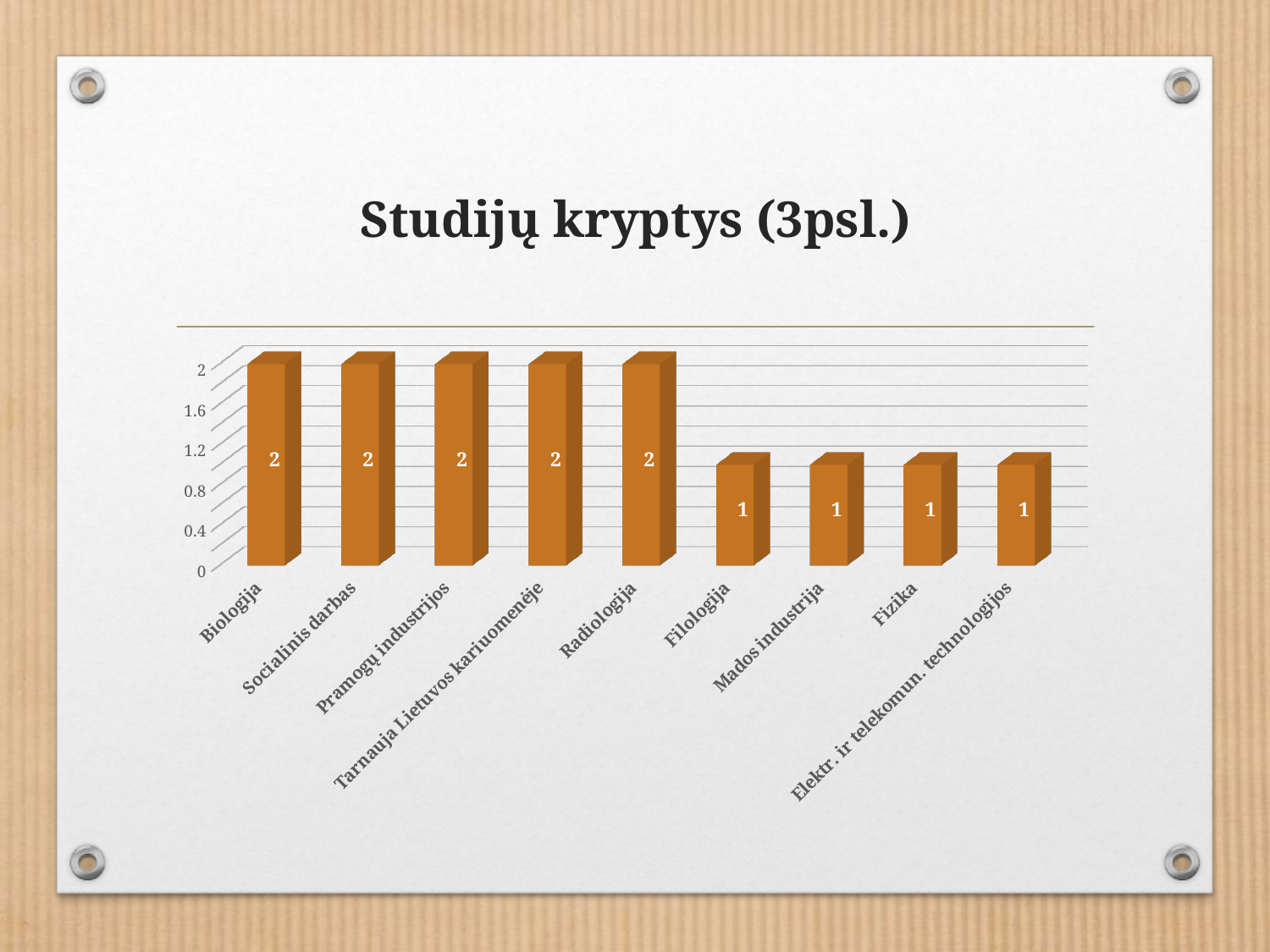
What is the title of the slide? Studijų kryptys (3psl.) What is the value for Fizika? 1 Which is larger, the value for Pramogų industrijos or the value for Mados industrija? Pramogų industrijos What is the value for Radiologija? 2 Do the values rise or fall from left to right along the x axis? fall What is the value for Biologija? 2 What is the value for Tarnauja Lietuvos kariuomenėje? 2 What is the value for Elektr. ir telekomun. technologijos? 1 What kind of chart is shown on the slide? bar chart What is the difference between the values for Socialinis darbas and Filologija? 1 How many categories have a value of 2? 5 How many categories are shown on the x axis? 9